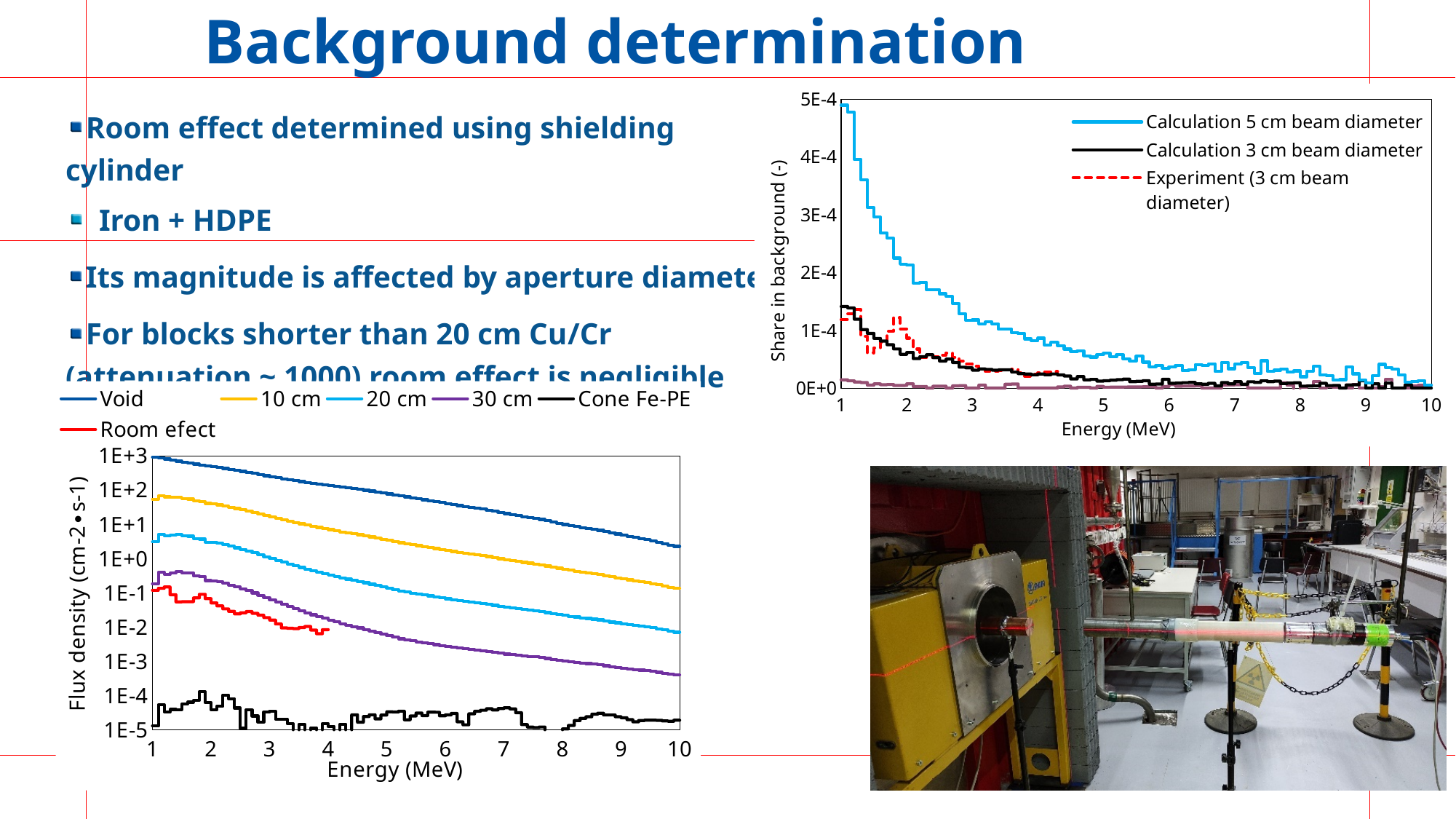
What is the y-axis label of the top-right chart? Share in background (-) What kind of chart is the chart at the bottom left of the slide (Flux density vs Energy)? line chart In the bottom-left flux density chart, is the flux density of the 10 cm series at 1 MeV greater or less than 1E+2? less In the top-right 'Share in background' chart, is the value of the 'Calculation 5 cm beam diameter' series at 1 MeV greater or less than 4E-4? greater How many series does the legend of the top-right 'Share in background' chart list? 3 In the bottom-left flux density chart, which series has the highest flux density across the energy range? Void In the bottom-left flux density chart, is the flux density of the Void series at 10 MeV greater or less than 1E+0? greater In the top-right 'Share in background' chart, does the share in background for the 'Calculation 5 cm beam diameter' series rise or fall as energy increases from 1 to 10 MeV? fall In the bottom-left flux density chart, which series has the lowest flux density across the energy range? Cone Fe-PE In the bottom-left flux density chart, which is larger at 5 MeV: the Void series or the 30 cm series? Void How many series does the legend of the bottom-left flux density chart list? 6